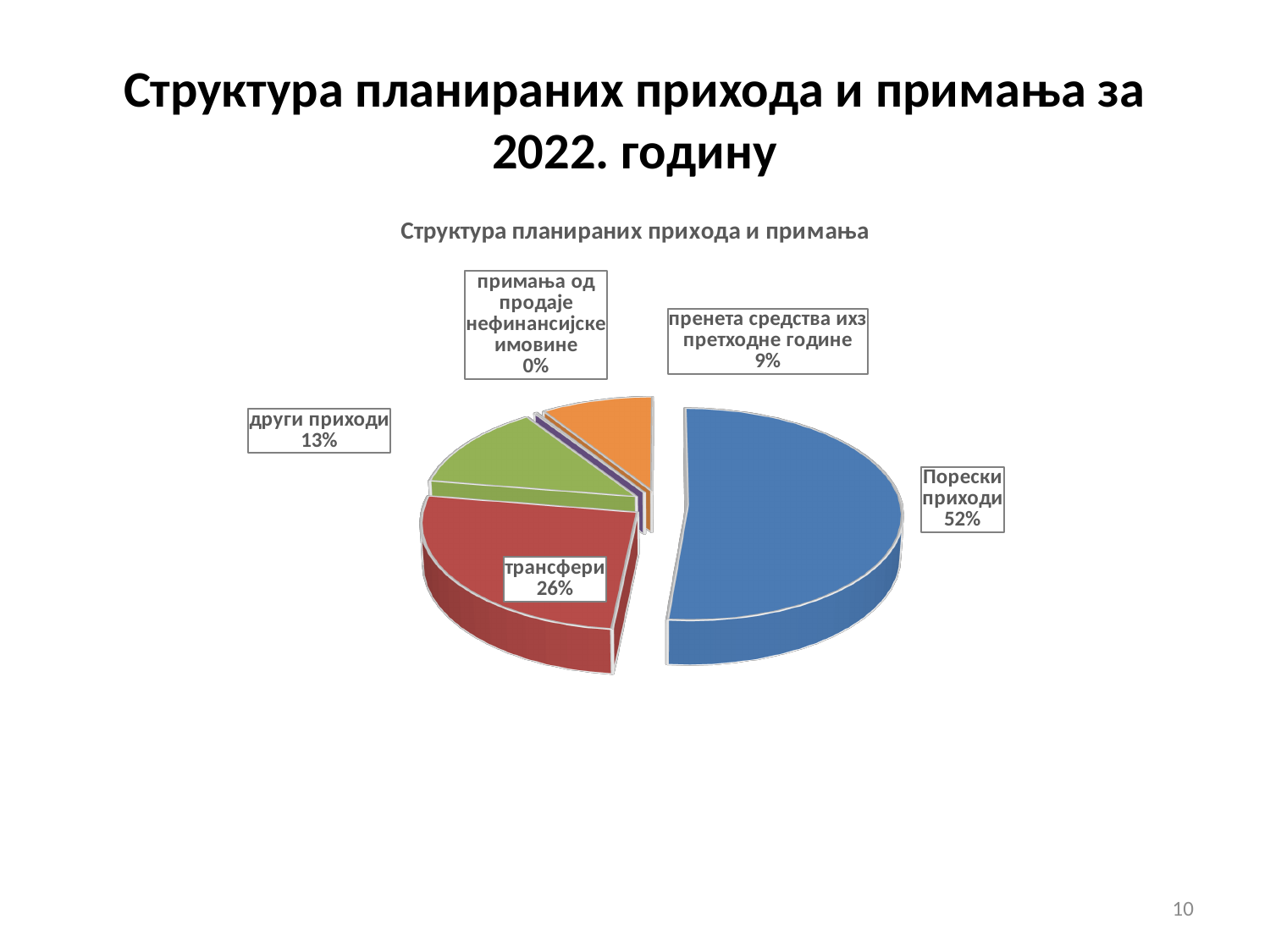
What is the difference between the shares of Порески приходи and трансфери? 26% Which is larger, the share for други приходи or the share for пренета средства ихз претходне године? други приходи What is the value shown for други приходи? 13% What is the value shown for пренета средства ихз претходне године? 9% What is the value shown for примања од продаје нефинансијске имовине? 0% What is the value shown for трансфери? 26% Which category has the smallest share of the pie? примања од продаје нефинансијске имовине What is the title of the chart? Структура планираних прихода и примања What share of the pie does Порески приходи have? 52% Which category has the largest share of the pie? Порески приходи How many categories are shown in the pie chart? 5 What kind of chart is shown on the slide? Pie chart